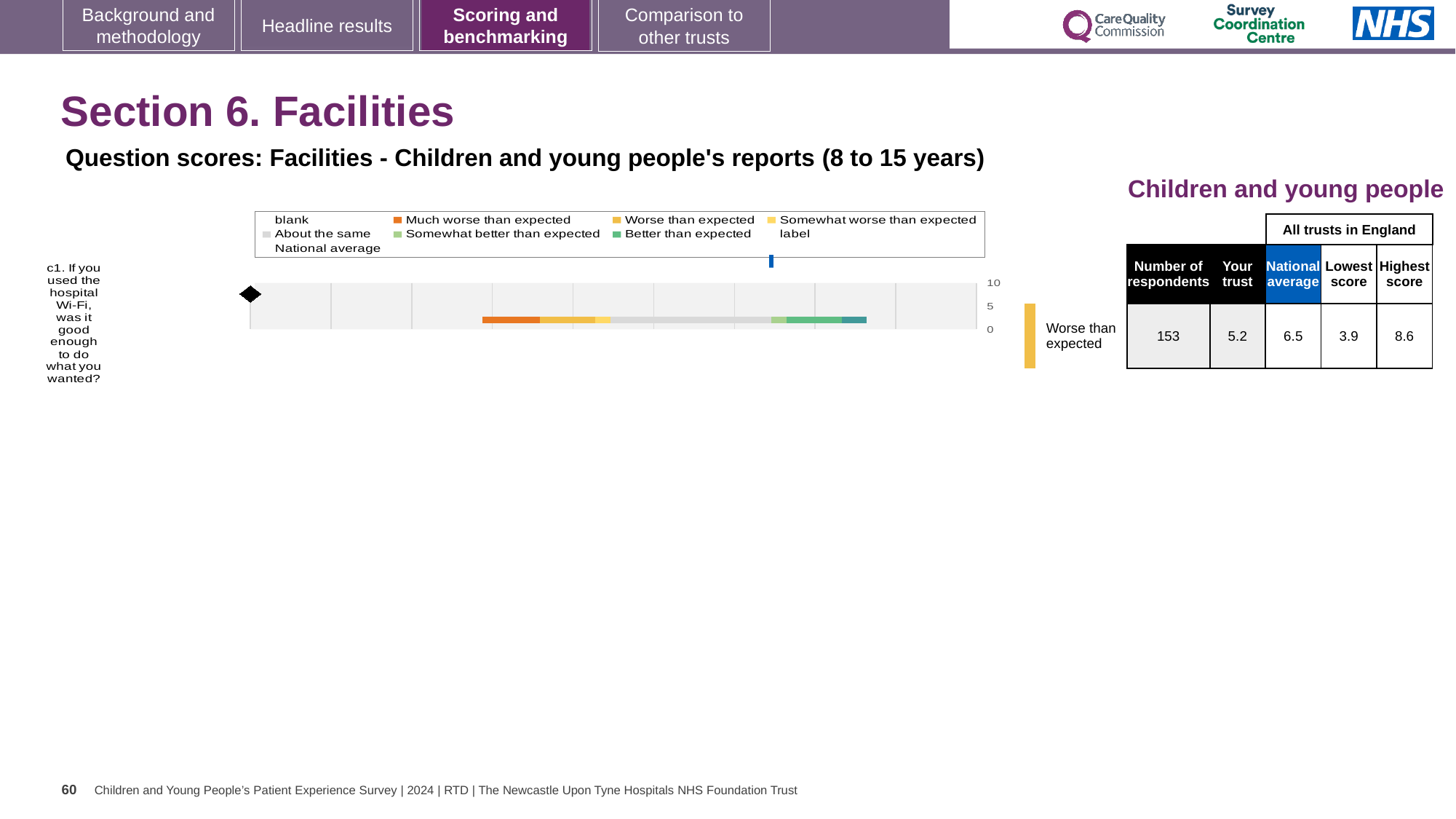
What rating category is shown beside the chart for question c1? Worse than expected In the table next to the chart, what is the national average score for question c1? 6.5 In the table next to the chart, what is the highest score among all trusts in England for question c1? 8.6 In the table next to the chart, how many respondents answered question c1? 153 In the table next to the chart, which is larger for question c1: the 'Your trust' score or the national average? national average What kind of chart is shown on the slide? bar chart What is the label of the single question plotted in the chart? c1. If you used the hospital Wi-Fi, was it good enough to do what you wanted? In the table next to the chart, what is the lowest score among all trusts in England for question c1? 3.9 In the table next to the chart, what is the 'Your trust' score for question c1? 5.2 Which colour does the legend use for 'Much worse than expected'? orange In the table next to the chart, what is the difference between the highest score and the lowest score for question c1? 4.7 How many questions (categories) are plotted in the chart? 1